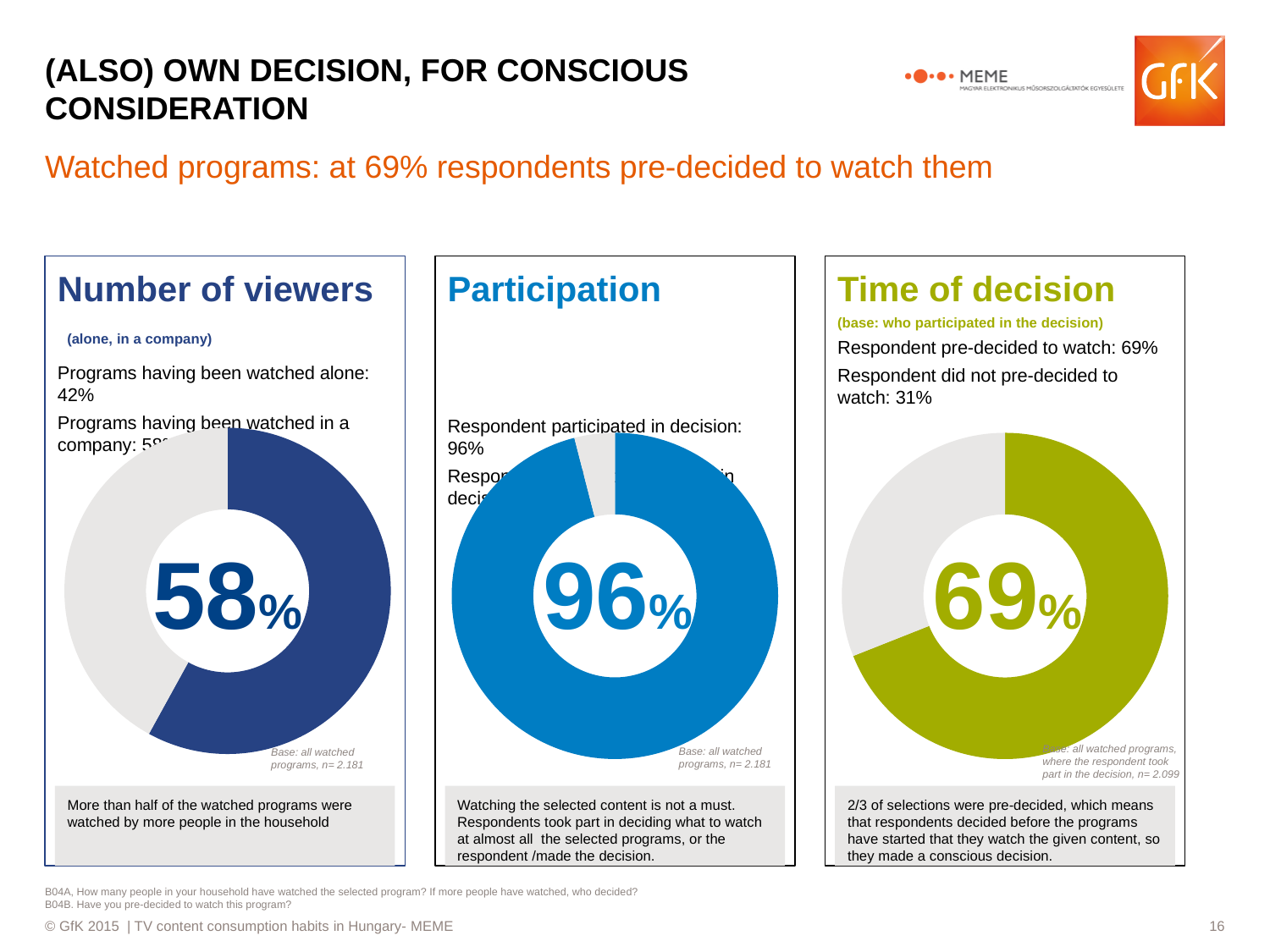
In the 'Time of decision' chart, what share of programs did the respondent not pre-decide to watch? 31% In the 'Participation' chart, what share of programs did the respondent participate in the decision? 96% In the 'Number of viewers' chart, which is larger: programs watched alone or programs watched in a company? Programs watched in a company In the 'Time of decision' chart, what share of programs did the respondent pre-decide to watch? 69% What is the base (n) stated for the 'Time of decision' chart? n= 2.099 In the 'Number of viewers' chart, what share of programs were watched alone? 42% In the 'Number of viewers' chart, what share of programs were watched in a company? 58% In the 'Time of decision' chart, what is the difference between the pre-decided share and the not pre-decided share? 38 percentage points In the 'Number of viewers' chart, what is the difference between the share watched in a company and the share watched alone? 16 percentage points How many donut charts are shown on the slide? 3 In the 'Participation' chart, is the share of programs where the respondent participated in the decision greater or less than 90%? greater What kind of chart is used in the 'Number of viewers' panel? Donut (pie) chart